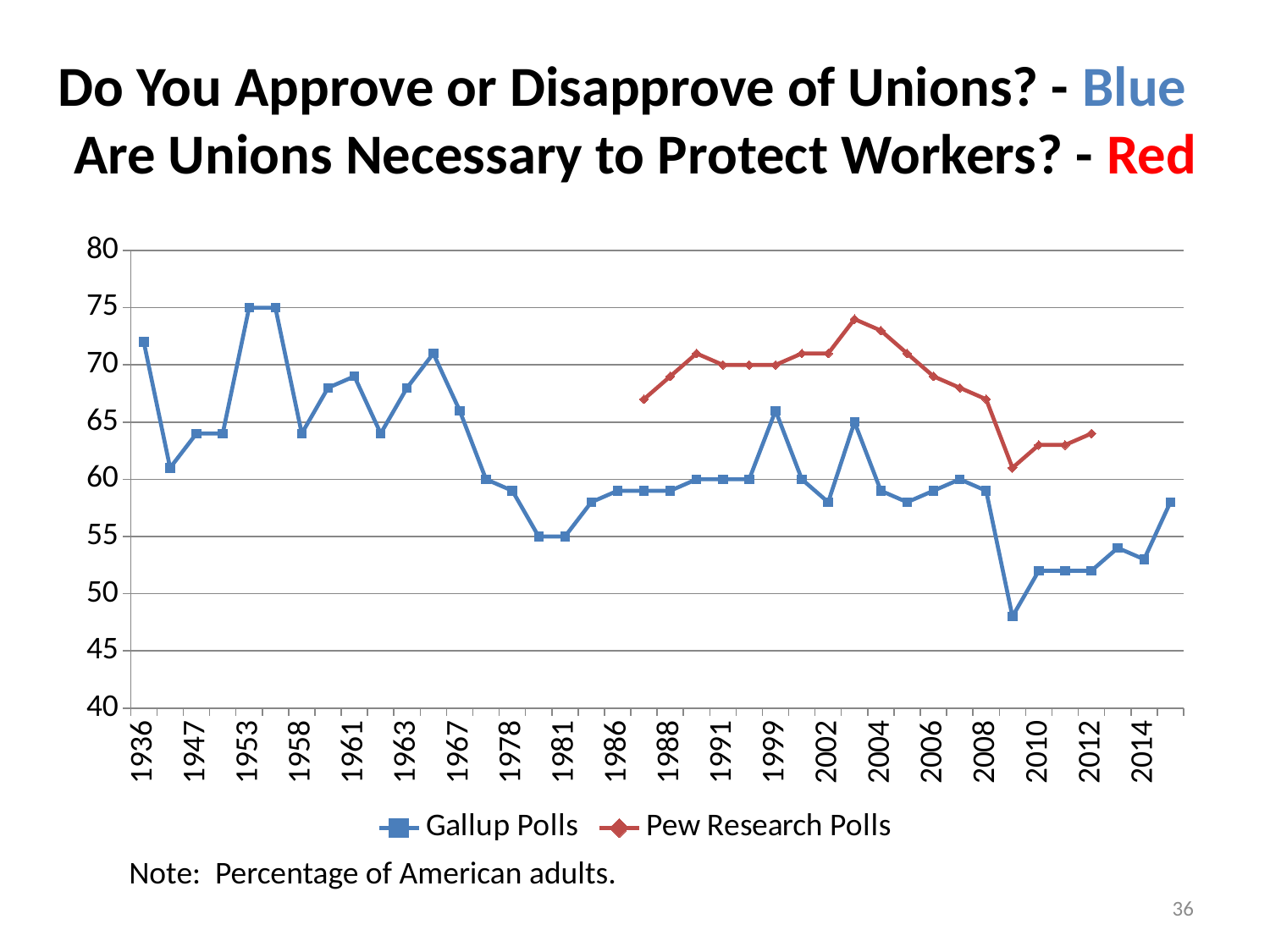
What are the two series named in the legend? Gallup Polls and Pew Research Polls Is the Gallup Polls value for 1936 greater or less than 70? greater Is the Gallup Polls value for 2010 greater or less than 55? less In 2004, which series has the higher value, Gallup Polls or Pew Research Polls? Pew Research Polls Which is larger, the Gallup Polls value for 1953 or for 2010? 1953 Is the Pew Research Polls value for 2004 greater or less than 70? greater How many series does the legend list? 2 Does the Gallup Polls series generally rise or fall from 1936 to 2014? fall What is the Gallup Polls value for 1981? 55 What is the Pew Research Polls value for 1991? 70 What is the Gallup Polls value for 1953? 75 What kind of chart is shown on the slide? line chart